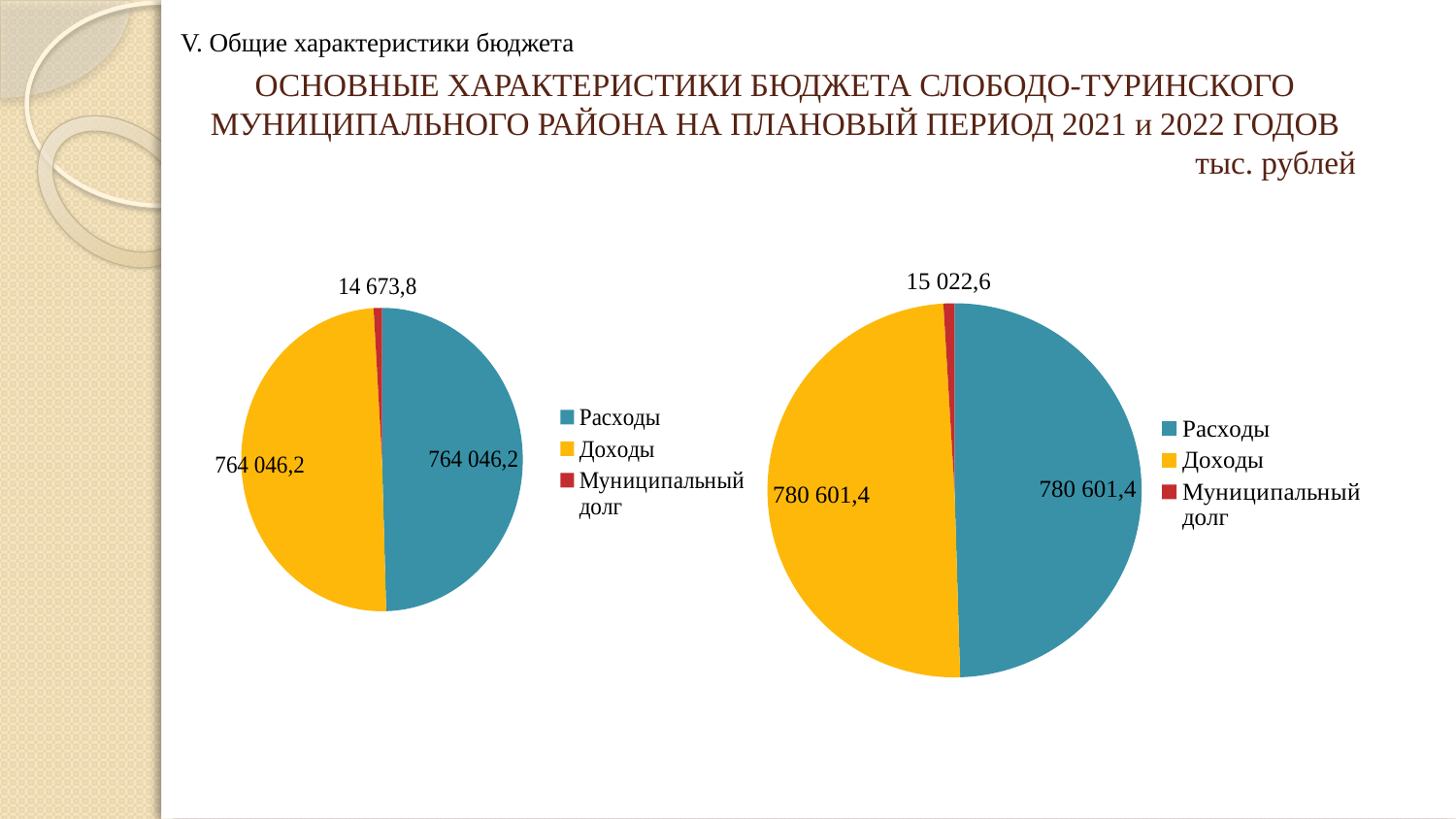
In the right pie chart, which is larger, Расходы or Муниципальный долг? Расходы In the right pie chart, what is the value for Муниципальный долг? 15 022,6 What type of chart is shown on the left of the slide? Pie chart What is the difference between the Расходы value in the right pie chart and the Расходы value in the left pie chart? 16 555,2 In the right pie chart, what is the value for Доходы? 780 601,4 In the left pie chart, what is the value for Муниципальный долг? 14 673,8 In the left pie chart, what colour represents Доходы? Yellow In the left pie chart, what is the difference between Расходы and Муниципальный долг? 749 372,4 In the left pie chart, what is the value for Расходы? 764 046,2 What unit of measurement is stated on the slide for the chart values? тыс. рублей In the left pie chart, which category has the smallest value? Муниципальный долг How many categories does the legend of the right pie chart list? 3